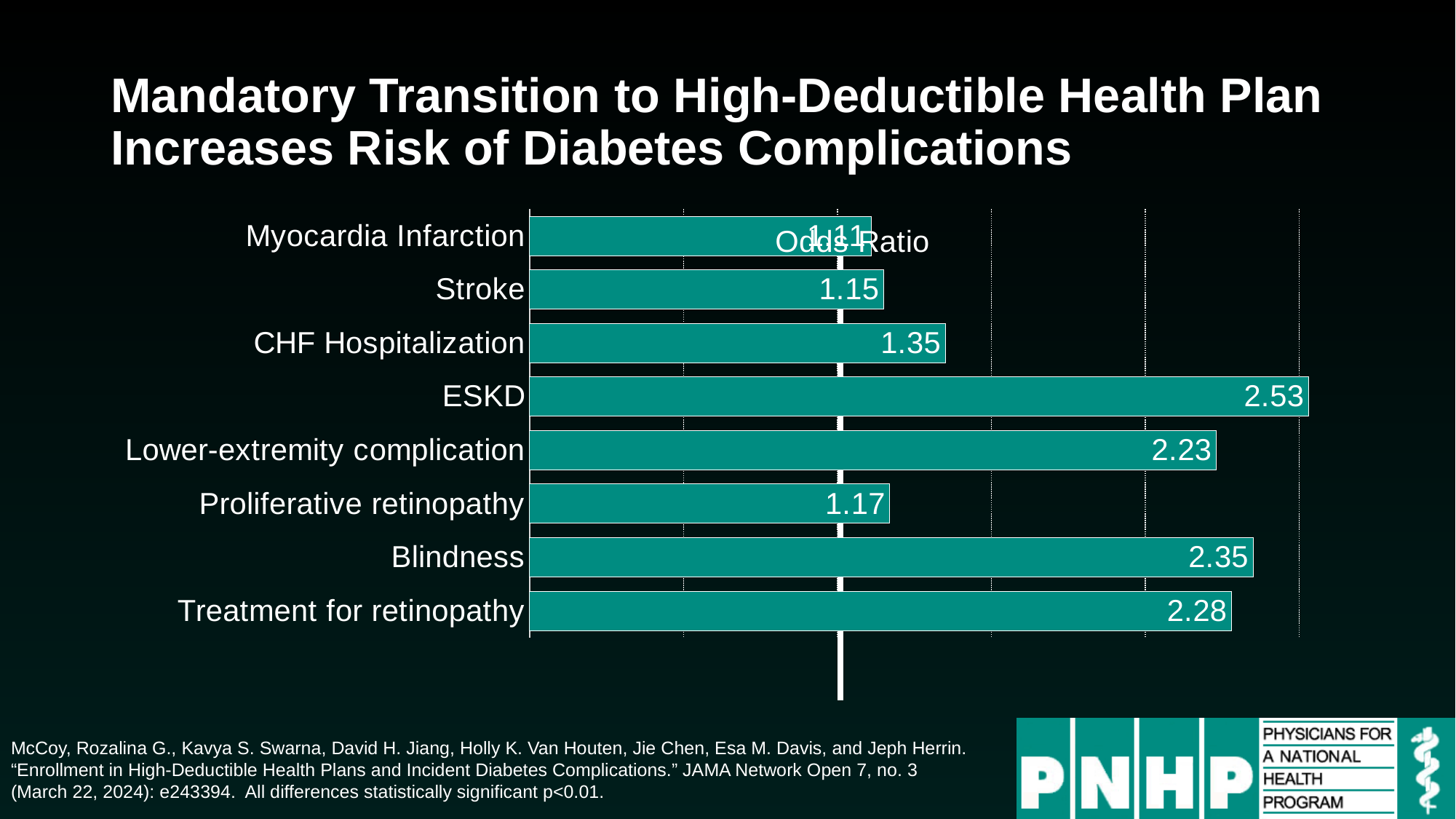
Which complication has the highest odds ratio? ESKD How many complications are shown in the chart? 8 What is the odds ratio for Stroke? 1.15 What is the difference between the odds ratios for Blindness and Proliferative retinopathy? 1.18 What is the odds ratio for ESKD? 2.53 What is the difference between the odds ratios for ESKD and Stroke? 1.38 Which has a larger odds ratio, Lower-extremity complication or CHF Hospitalization? Lower-extremity complication What is the odds ratio for Blindness? 2.35 What kind of chart is shown on the slide? Bar chart What is the odds ratio for CHF Hospitalization? 1.35 What is the odds ratio for Treatment for retinopathy? 2.28